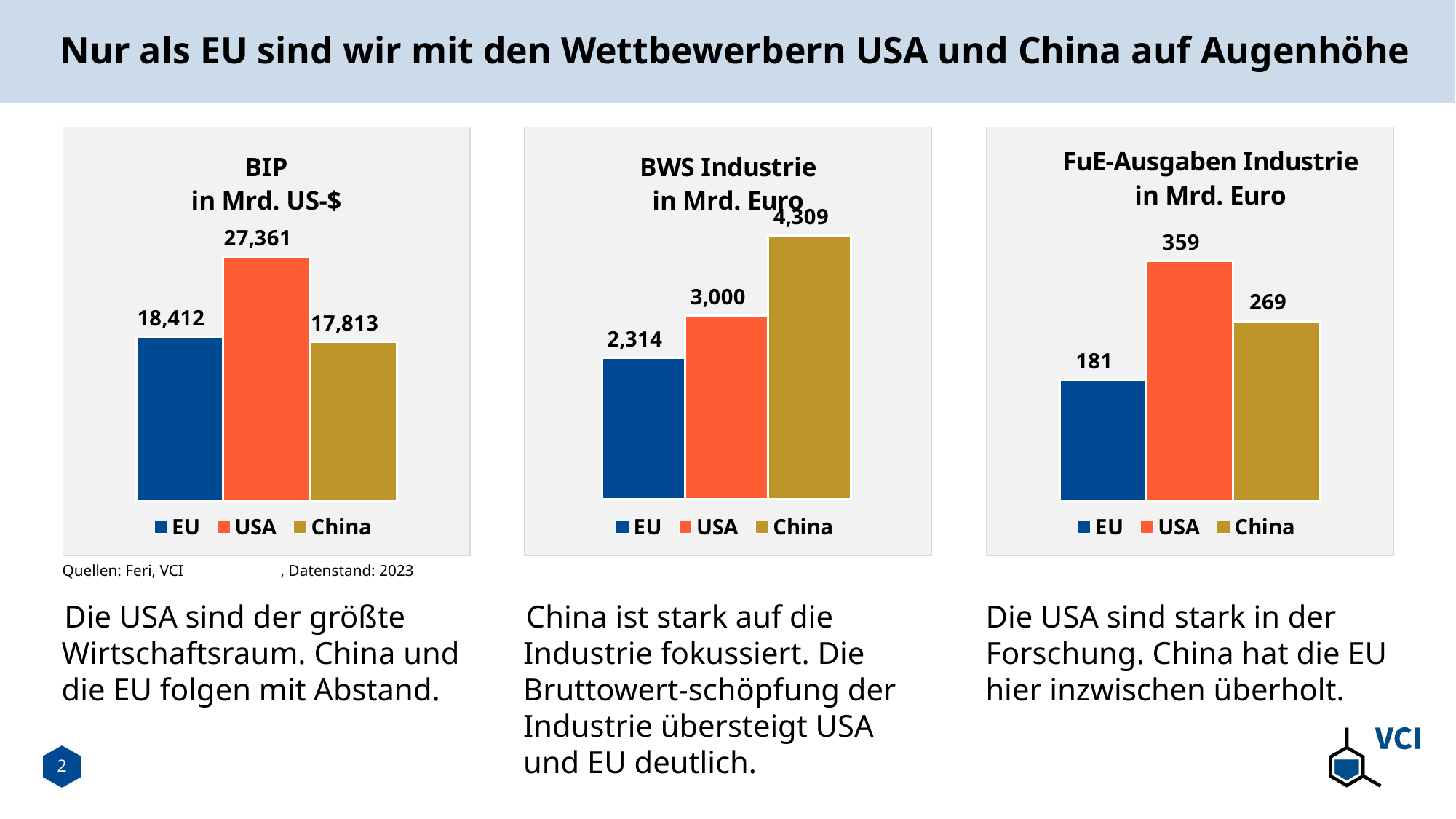
In the 'FuE-Ausgaben Industrie in Mrd. Euro' chart, what is the difference between the USA and China? 90 In the 'BWS Industrie in Mrd. Euro' chart, what is the difference between the USA and the EU? 686 How many series does the legend of the 'BIP in Mrd. US-$' chart list? 3 In the 'BIP in Mrd. US-$' chart, which region has the lowest value? China In the 'BWS Industrie in Mrd. Euro' chart, which region has the highest value? China In the 'FuE-Ausgaben Industrie in Mrd. Euro' chart, what is the value for the EU? 181 In the 'FuE-Ausgaben Industrie in Mrd. Euro' chart, which is larger, the value for China or the value for the EU? China In the 'BWS Industrie in Mrd. Euro' chart, what is the value for China? 4,309 In the 'BIP in Mrd. US-$' chart, what is the value for the EU? 18,412 What kind of chart is the 'FuE-Ausgaben Industrie in Mrd. Euro' chart? Bar chart In the 'BIP in Mrd. US-$' chart, what is the value for the USA? 27,361 In the 'BIP in Mrd. US-$' chart, what is the difference between the USA and the EU? 8,949